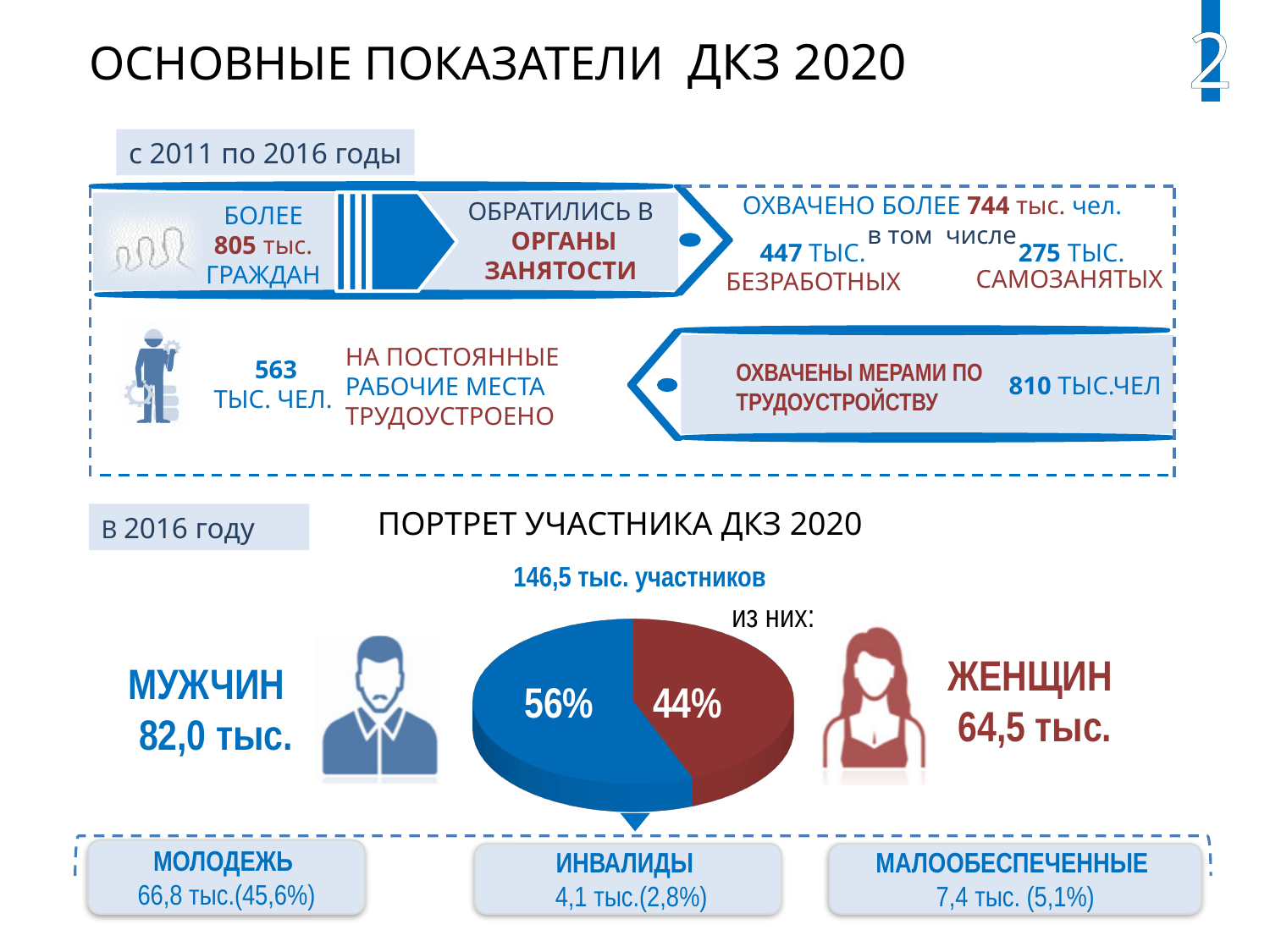
How many slices does the pie chart have? 2 What kind of chart is shown on the slide? pie chart Which slice of the pie chart is larger, the blue one (МУЖЧИН) or the red one (ЖЕНЩИН)? the blue one (МУЖЧИН) What total number of participants is shown above the pie chart? 146,5 тыс. участников Which group has the smallest share in the pie chart? ЖЕНЩИН How many thousand participants are women (ЖЕНЩИН) according to the pie chart labels? 64,5 тыс. What share of the pie chart is labelled 56%? 56% How many thousand participants are men (МУЖЧИН) according to the pie chart labels? 82,0 тыс. What is the difference in percentage points between the two slices of the pie chart? 12 What colour is the slice representing women (ЖЕНЩИН) in the pie chart? red What percentage is shown on the red slice of the pie chart? 44% What percentage is shown on the blue slice of the pie chart? 56%